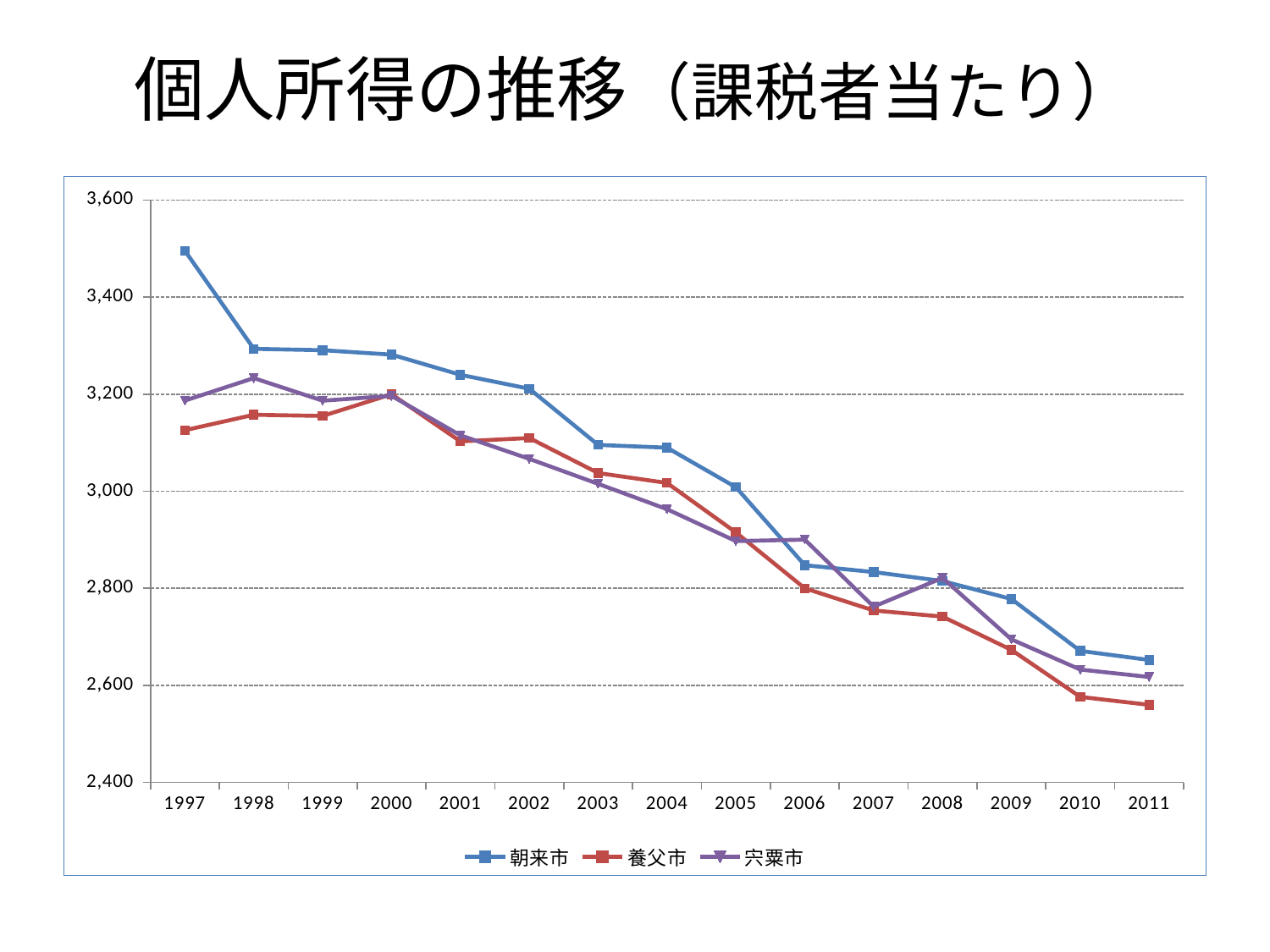
Which series is drawn in blue? 朝来市 Do the values for 朝来市 generally rise or fall from 1997 to 2011? fall Which series has the lowest value in 2011? 養父市 What kind of chart is shown on the slide? line chart What is the title of the chart on the slide? 個人所得の推移（課税者当たり） Is the value for 朝来市 in 1997 greater or less than 3,400? greater Is the value for 宍粟市 in 1998 greater or less than 3,200? greater How many years are plotted along the x axis? 15 In 2004, which is larger, the value for 朝来市 or the value for 宍粟市? 朝来市 Which series has the highest value in 1997? 朝来市 Is the value for 養父市 in 2011 greater or less than 2,600? less How many series does the legend list? 3